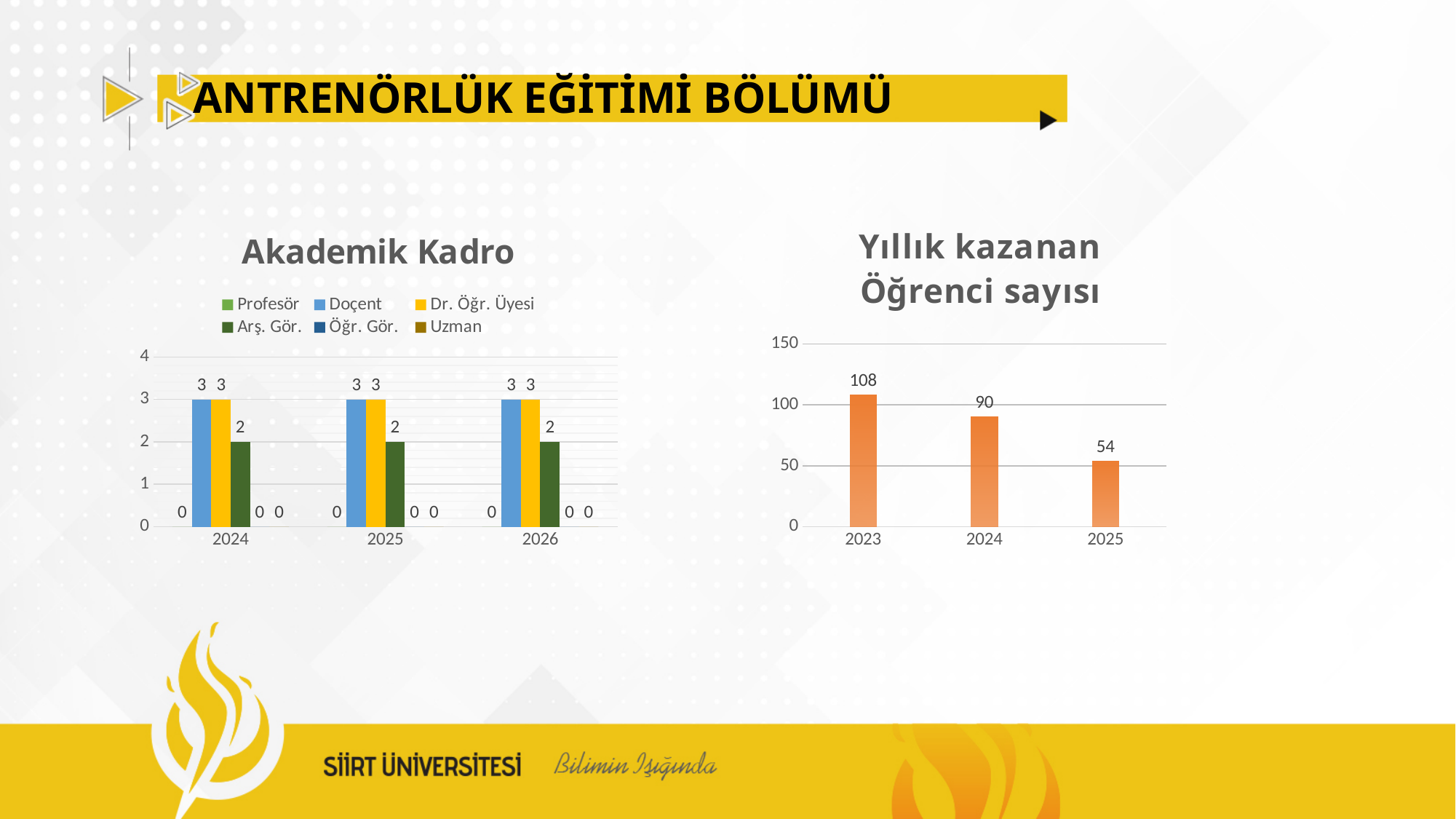
What kind of chart is the 'Akademik Kadro' chart? bar chart In the 'Yıllık kazanan Öğrenci sayısı' chart, which year has the lowest value? 2025 In the 'Yıllık kazanan Öğrenci sayısı' chart, how many years are shown on the x axis? 3 In the 'Akademik Kadro' chart, what is the value for Arş. Gör. in 2026? 2 In the 'Yıllık kazanan Öğrenci sayısı' chart, which year has the highest value? 2023 In the 'Akademik Kadro' chart, what is the value for Doçent in 2025? 3 In the 'Akademik Kadro' chart, which is larger in 2024: Dr. Öğr. Üyesi or Arş. Gör.? Dr. Öğr. Üyesi In the 'Yıllık kazanan Öğrenci sayısı' chart, what is the value for 2025? 54 In the 'Akademik Kadro' chart, how many series does the legend list? 6 In the 'Yıllık kazanan Öğrenci sayısı' chart, what is the value for 2023? 108 In the 'Yıllık kazanan Öğrenci sayısı' chart, what is the difference between the values for 2023 and 2024? 18 In the 'Yıllık kazanan Öğrenci sayısı' chart, do the values rise or fall from 2023 to 2025? fall